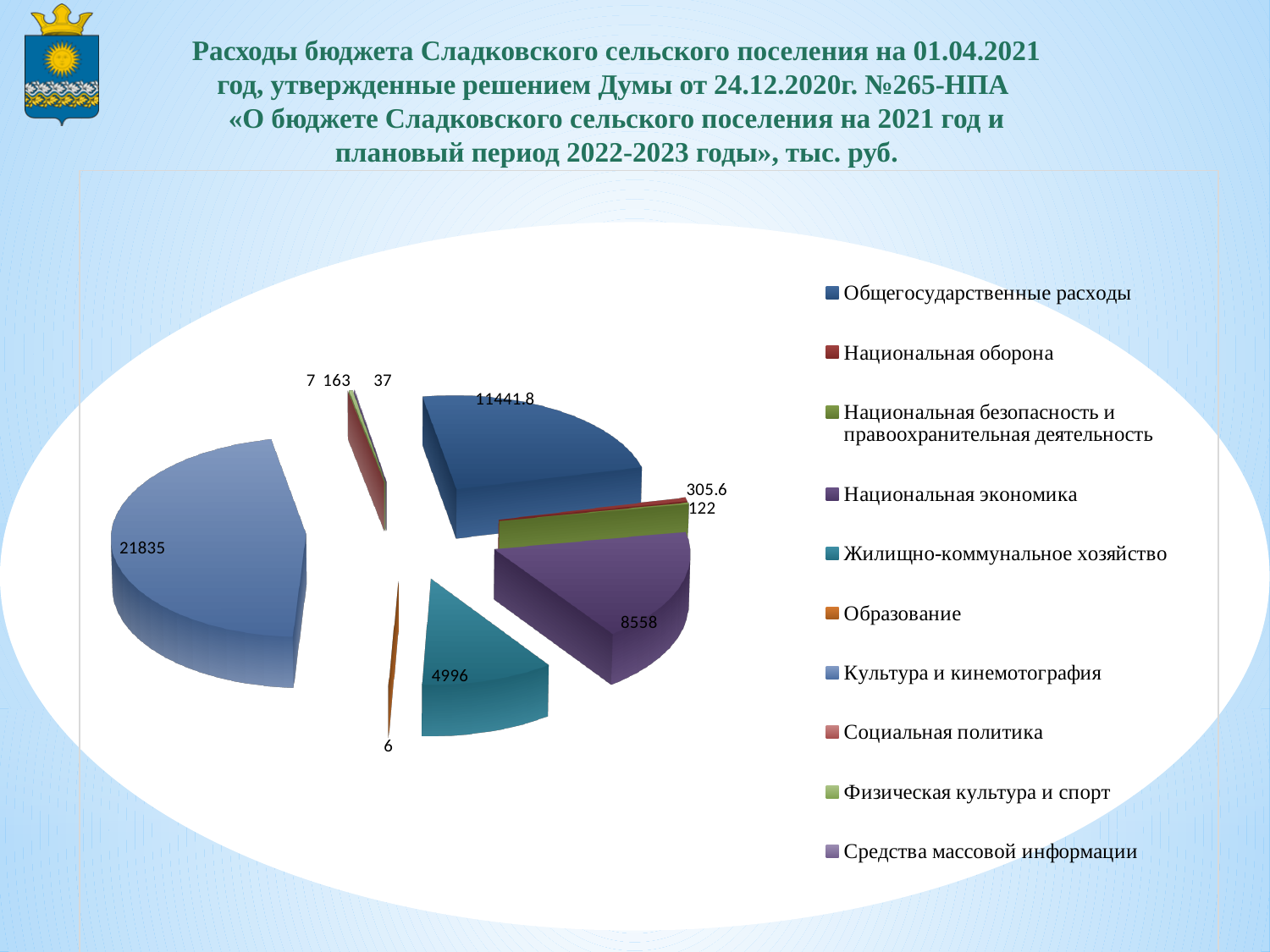
What is the value for Национальная экономика? 8558 What is the value for Национальная оборона? 305.6 What type of chart is shown on the slide? Pie chart Which category has the largest value? Культура и кинемотография What is the value for Культура и кинемотография? 21835 What is the value for Общегосударственные расходы? 11441.8 What is the value for Жилищно-коммунальное хозяйство? 4996 What is the difference between Культура и кинемотография and Общегосударственные расходы? 10393.2 Which is larger, Национальная экономика or Жилищно-коммунальное хозяйство? Национальная экономика What is the difference between Национальная экономика and Жилищно-коммунальное хозяйство? 3562 How many categories does the legend list? 10 What is the value for Национальная безопасность и правоохранительная деятельность? 122